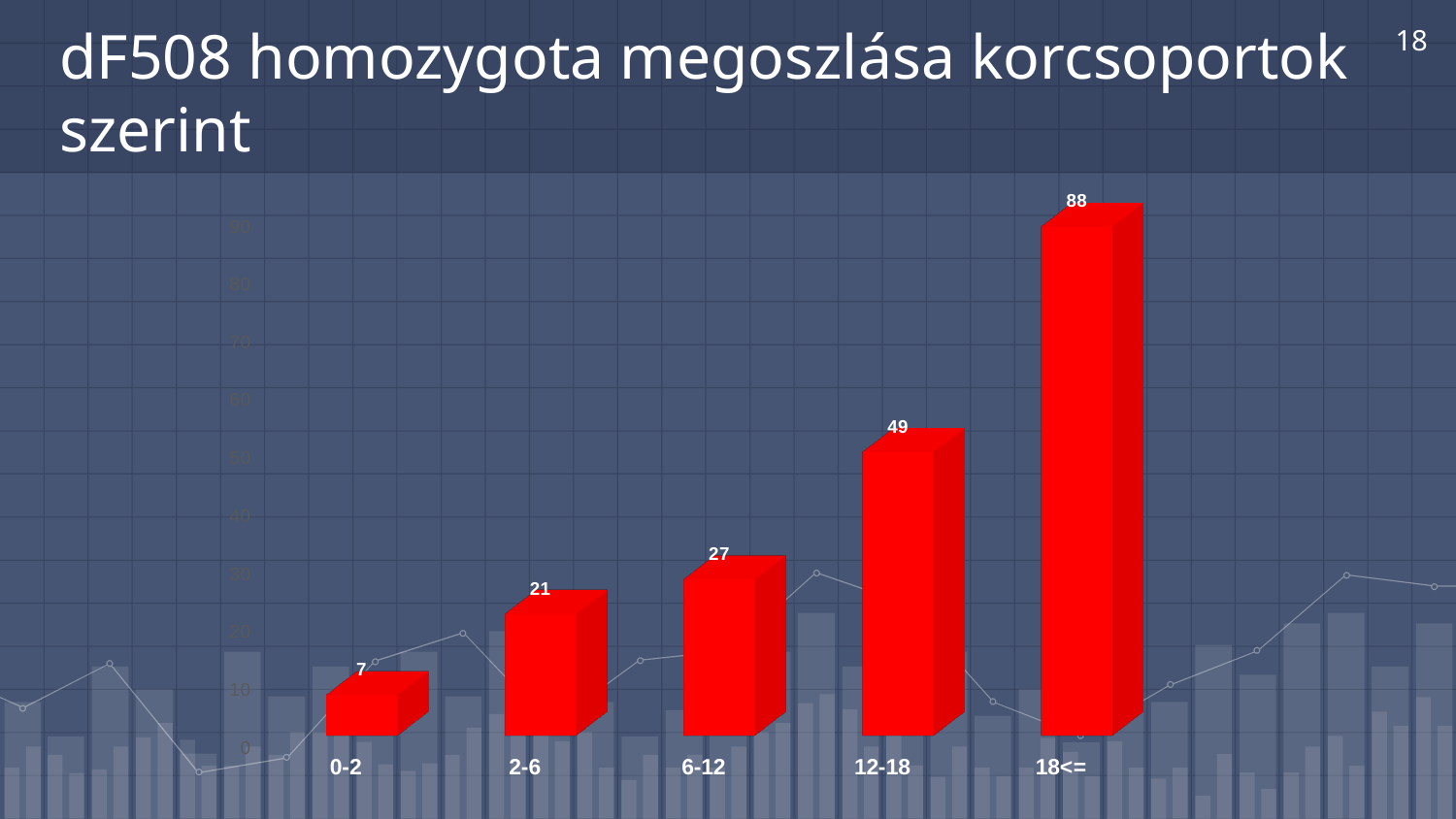
What is the value for the 18<= age group? 88 What is the value for the 12-18 age group? 49 Which age group has the highest value? 18<= What is the difference between the values for 18<= and 12-18? 39 What is the value for the 0-2 age group? 7 Which is larger, the value for 2-6 or the value for 6-12? 6-12 How many age groups are shown on the chart? 5 Do the values rise or fall from the 0-2 group to the 18<= group? rise What is the value for the 2-6 age group? 21 What is the value for the 6-12 age group? 27 What kind of chart is shown on the slide? bar chart Which age group has the lowest value? 0-2